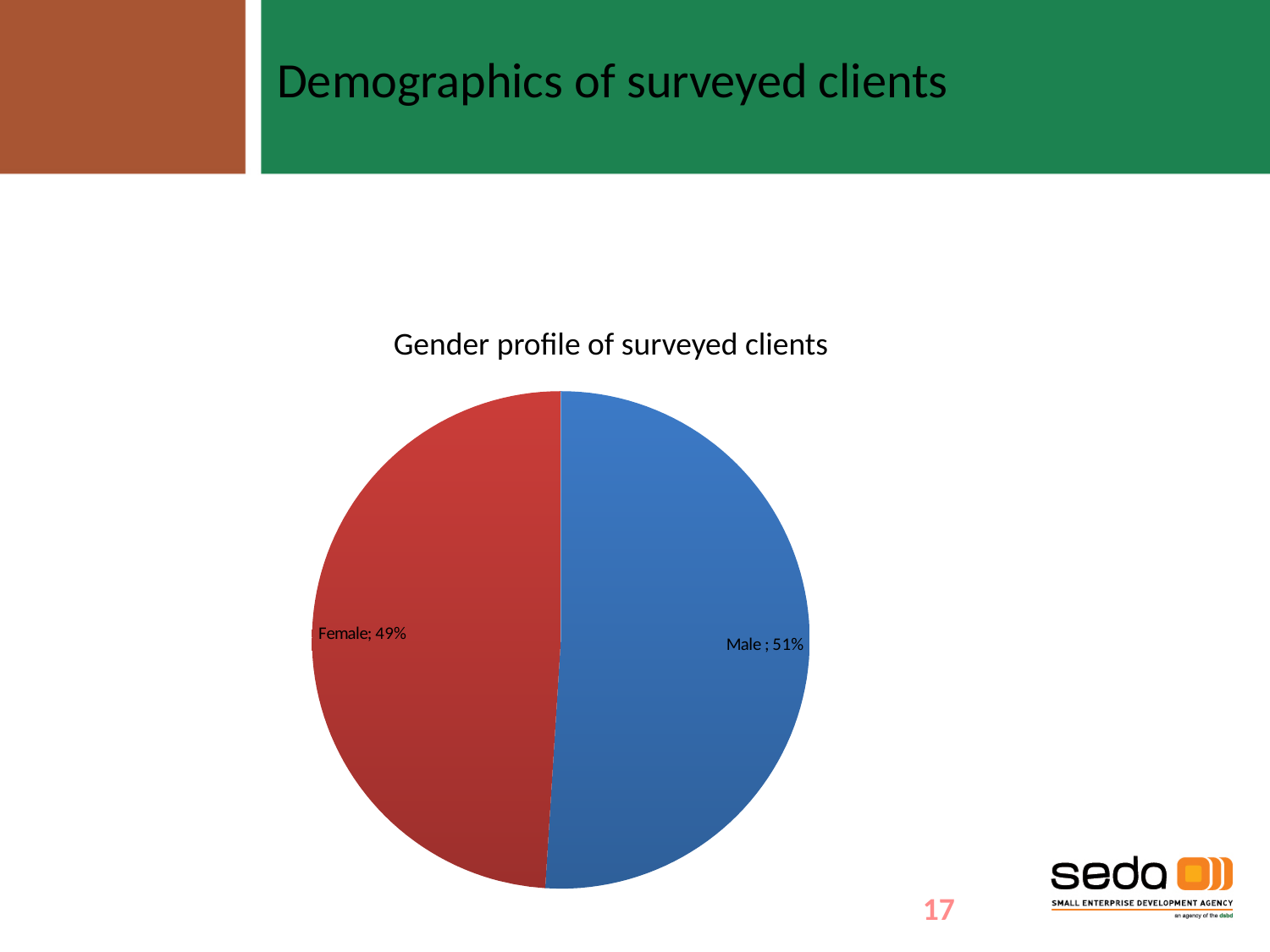
Is the Female share larger or smaller than the Male share? smaller What is the difference in percentage points between the Male and Female shares? 2% What share of the pie does the Male slice represent? 51% What percentage of surveyed clients are Female? 49% What is the title of the chart? Gender profile of surveyed clients Which gender has the larger share of surveyed clients? Male How many slices does the pie chart have? 2 What percentage of surveyed clients are Male? 51% Which gender has the smaller share of surveyed clients? Female What kind of chart is shown on the slide? pie chart What colour is the Female slice of the pie chart? red